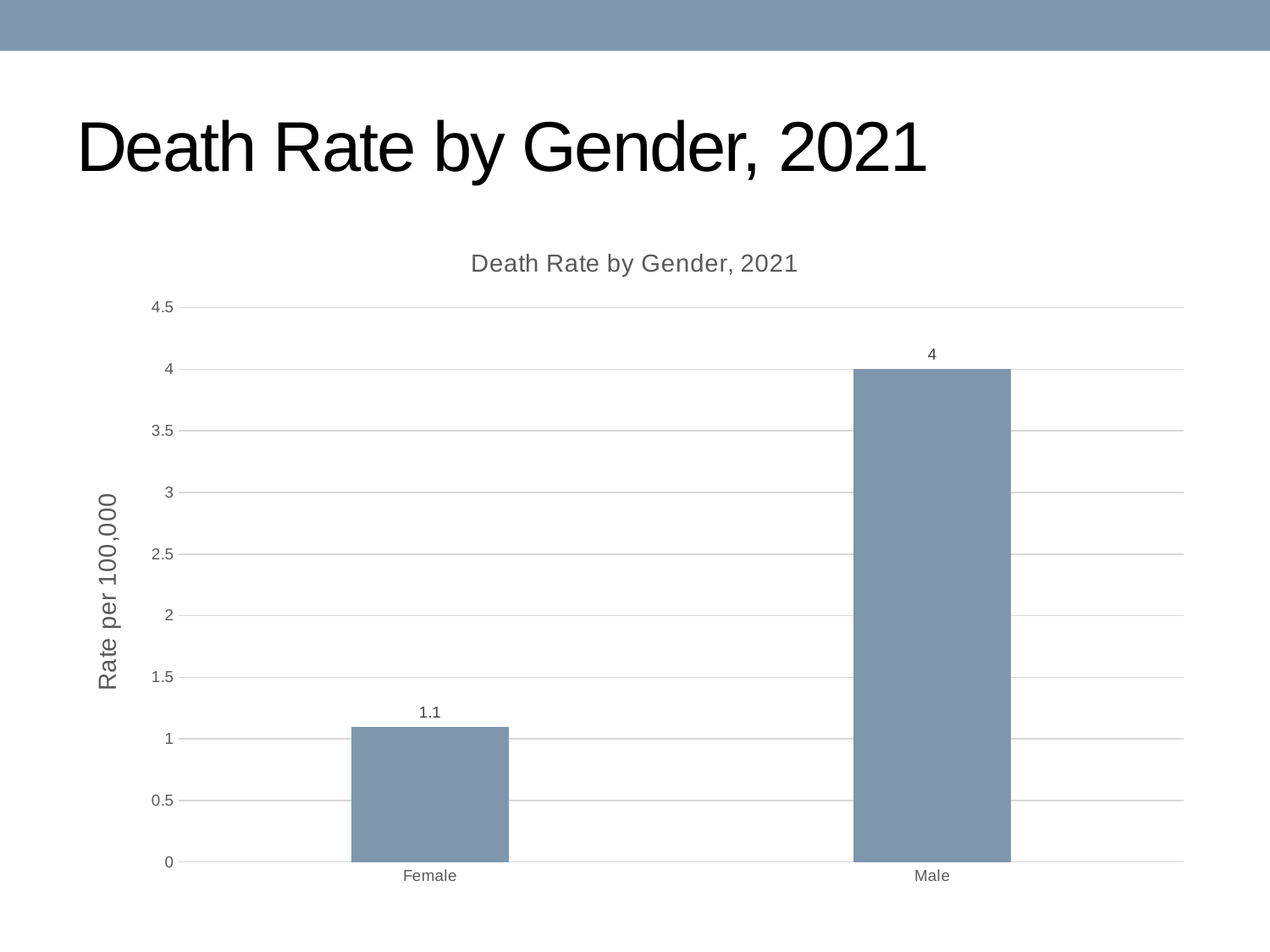
Which is larger, the death rate for Female or for Male? Male Is the value for Male greater or less than 3? greater What is the difference between the death rates for Male and Female? 2.9 Which gender has the lowest death rate? Female What is the title of the chart? Death Rate by Gender, 2021 What is the death rate for Male? 4 How many categories are shown on the x axis? 2 Is the value for Female greater or less than 1.5? less What is the death rate for Female? 1.1 What is the label of the y axis? Rate per 100,000 Which gender has the highest death rate? Male What kind of chart is shown on the slide? bar chart